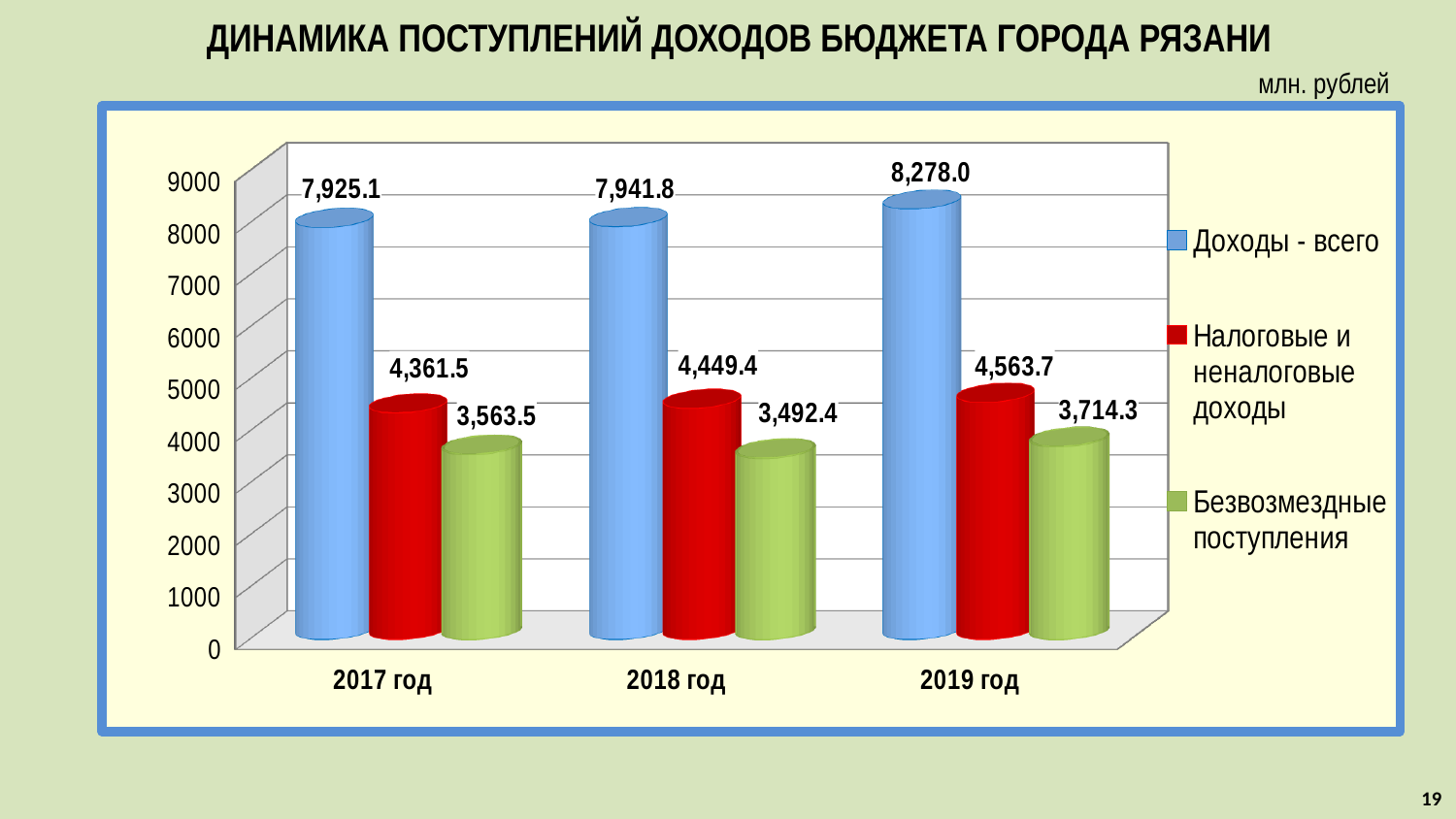
Does Доходы - всего rise or fall from 2017 год to 2019 год? rise What is the difference between Налоговые и неналоговые доходы in 2019 год and in 2018 год? 114.3 What is the value of Доходы - всего for 2019 год? 8,278.0 Which is larger: Безвозмездные поступления in 2017 год or in 2019 год? 2019 год What is the value of Безвозмездные поступления for 2018 год? 3,492.4 How many years are shown on the x axis? 3 How many series does the legend list? 3 What is the value of Налоговые и неналоговые доходы for 2017 год? 4,361.5 What is the difference between Доходы - всего in 2019 год and in 2017 год? 352.9 In which year is Доходы - всего the highest? 2019 год Is the value of Налоговые и неналоговые доходы for 2019 год greater or less than 4000? greater In which year is Безвозмездные поступления the lowest? 2018 год